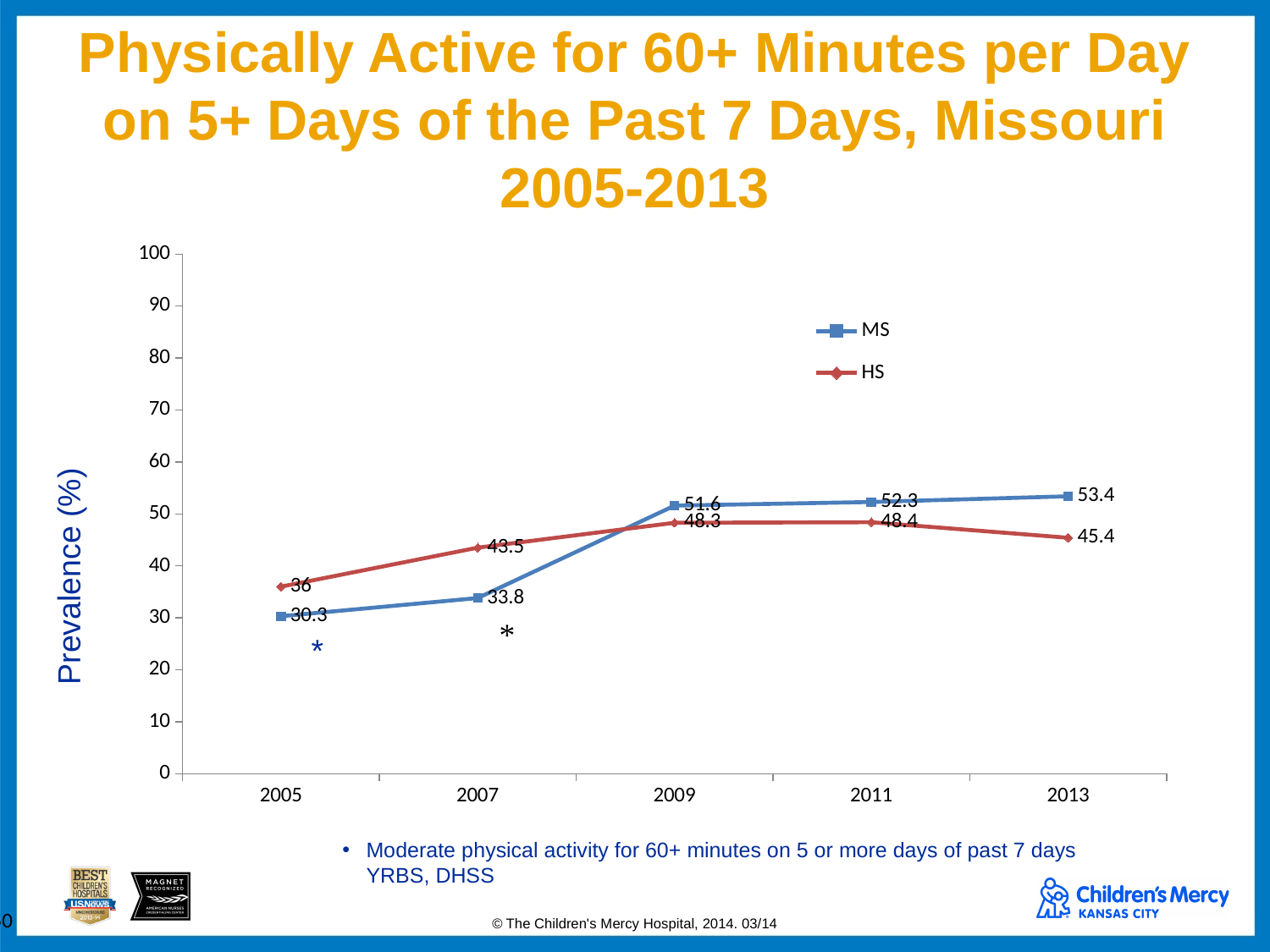
Does the MS series rise or fall from 2005 to 2013? Rise In which year is the MS series highest? 2013 What is the HS value in 2013? 45.4 What is the difference between the MS and HS values in 2013? 8 What is the MS value in 2011? 52.3 Which series has the larger value in 2007, MS or HS? HS What is the HS value in 2007? 43.5 In which year is the HS series lowest? 2005 How many years are shown on the x axis? 5 What is the MS value in 2005? 30.3 How many series does the legend list? 2 What kind of chart is shown on the slide? Line chart